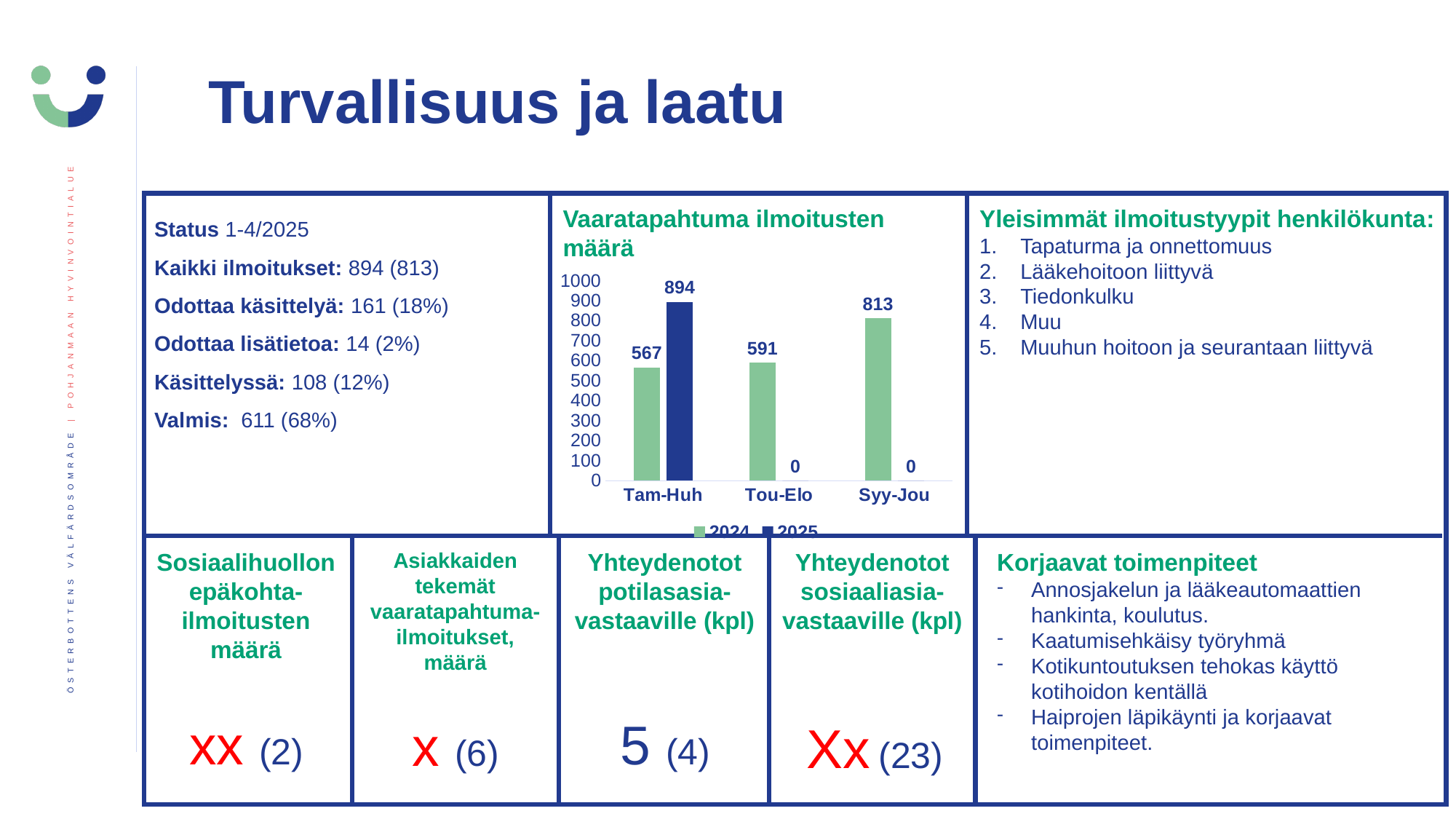
How many series does the chart's legend list? 2 What kind of chart is shown on the slide? Bar chart How many categories are shown on the x axis of the chart? 3 Which is larger in the Tam-Huh category, the 2024 value or the 2025 value? 2025 What is the title of the chart? Vaaratapahtuma ilmoitusten määrä What is the value for 2024 in the Tam-Huh category? 567 What is the value for 2025 in the Tou-Elo category? 0 What is the value for 2025 in the Tam-Huh category? 894 What is the difference between the 2025 and 2024 values in the Tam-Huh category? 327 Which category has the highest value for the 2024 series? Syy-Jou Which category has the lowest value for the 2024 series? Tam-Huh What is the value for 2024 in the Syy-Jou category? 813